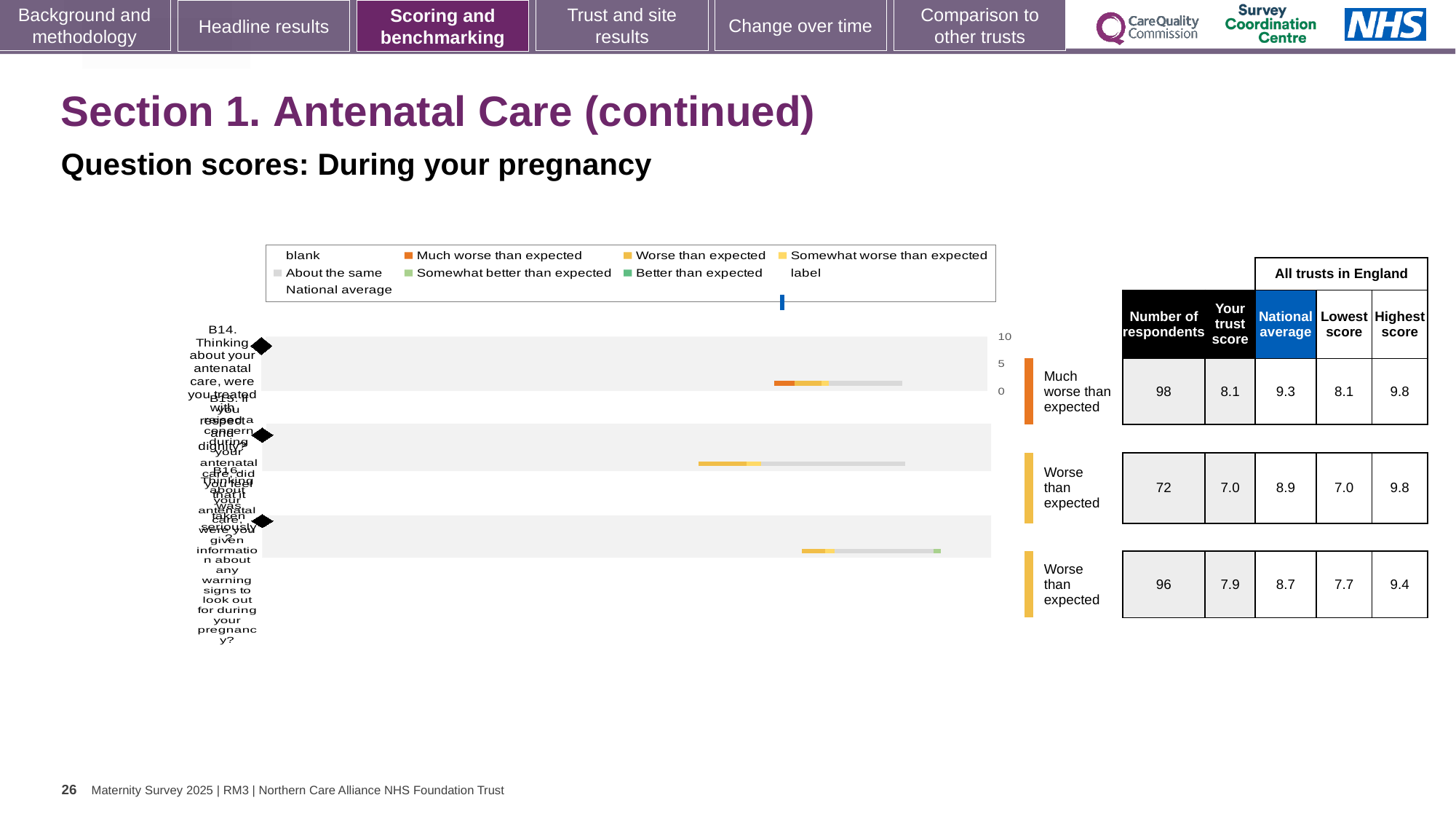
In the table, what is the trust score for the row labelled 'Much worse than expected'? 8.1 Which row of the table has the lowest trust score? the second row, 7.0 Is the trust score larger for the first row or the third row of the table? the first row In the table, what is the national average for the second row? 8.9 What colour represents 'Better than expected' in the legend? green What colour represents 'Much worse than expected' in the legend? orange In the table, what is the number of respondents for the row labelled 'Much worse than expected'? 98 In the table, what is the highest score for the third row? 9.4 For the row labelled 'Much worse than expected', what is the difference between the national average and the trust score? 1.2 How many question rows (bars) are plotted in the chart? 3 Which row of the table has the highest number of respondents? the first row (Much worse than expected), 98 What kind of chart is shown on the slide? bar chart